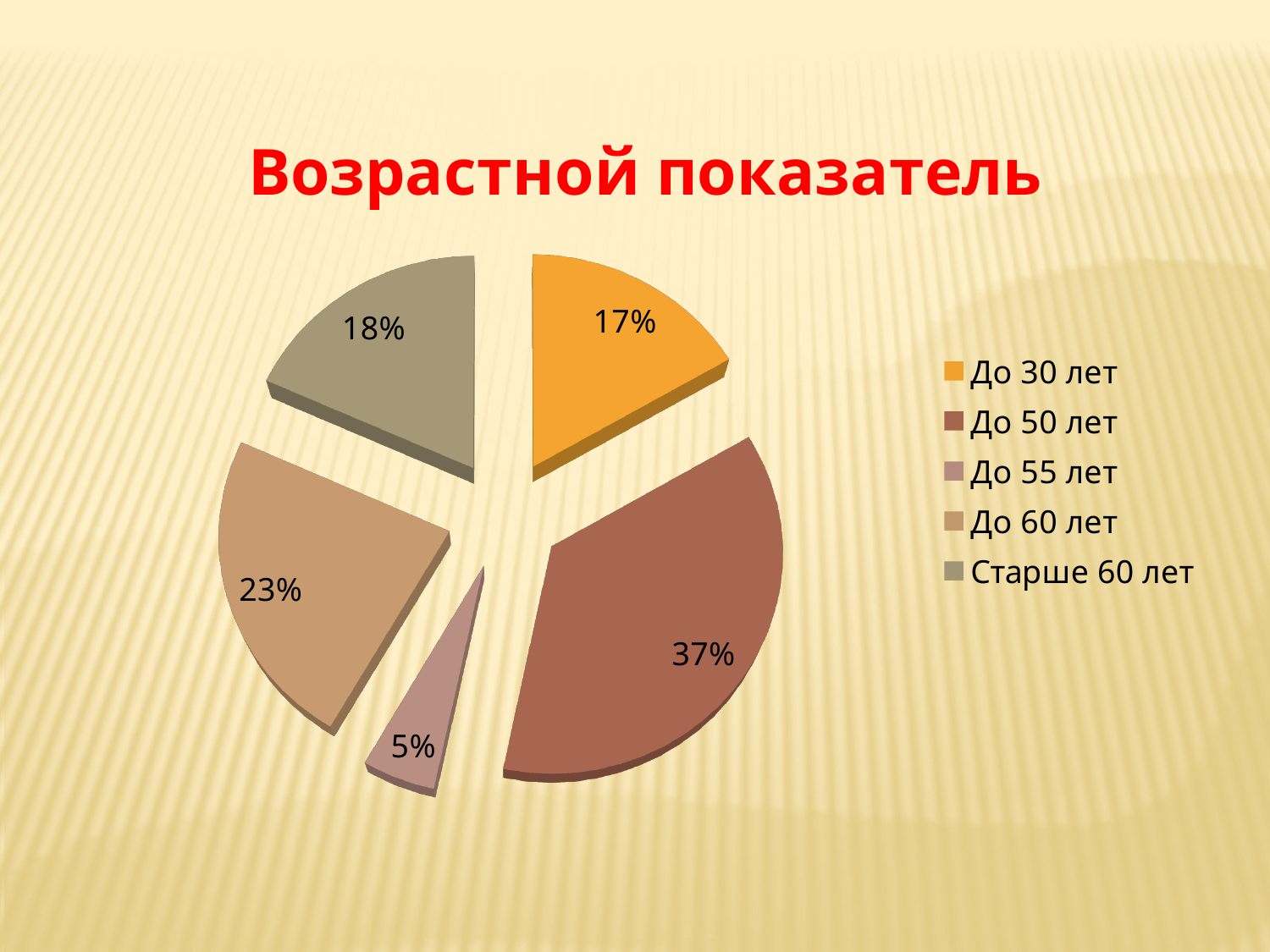
How many categories does the pie chart show? 5 What share of the pie does the 'Старше 60 лет' slice represent? 18% Which slice is larger, 'До 30 лет' or 'Старше 60 лет'? Старше 60 лет Which category has the largest slice of the pie? До 50 лет What is the difference in percentage points between the 'До 50 лет' and 'До 60 лет' slices? 14% What share of the pie does the 'До 50 лет' slice represent? 37% What share of the pie does the 'До 55 лет' slice represent? 5% What kind of chart is shown on the slide? Pie chart Which category has the smallest slice of the pie? До 55 лет What is the title of the slide? Возрастной показатель